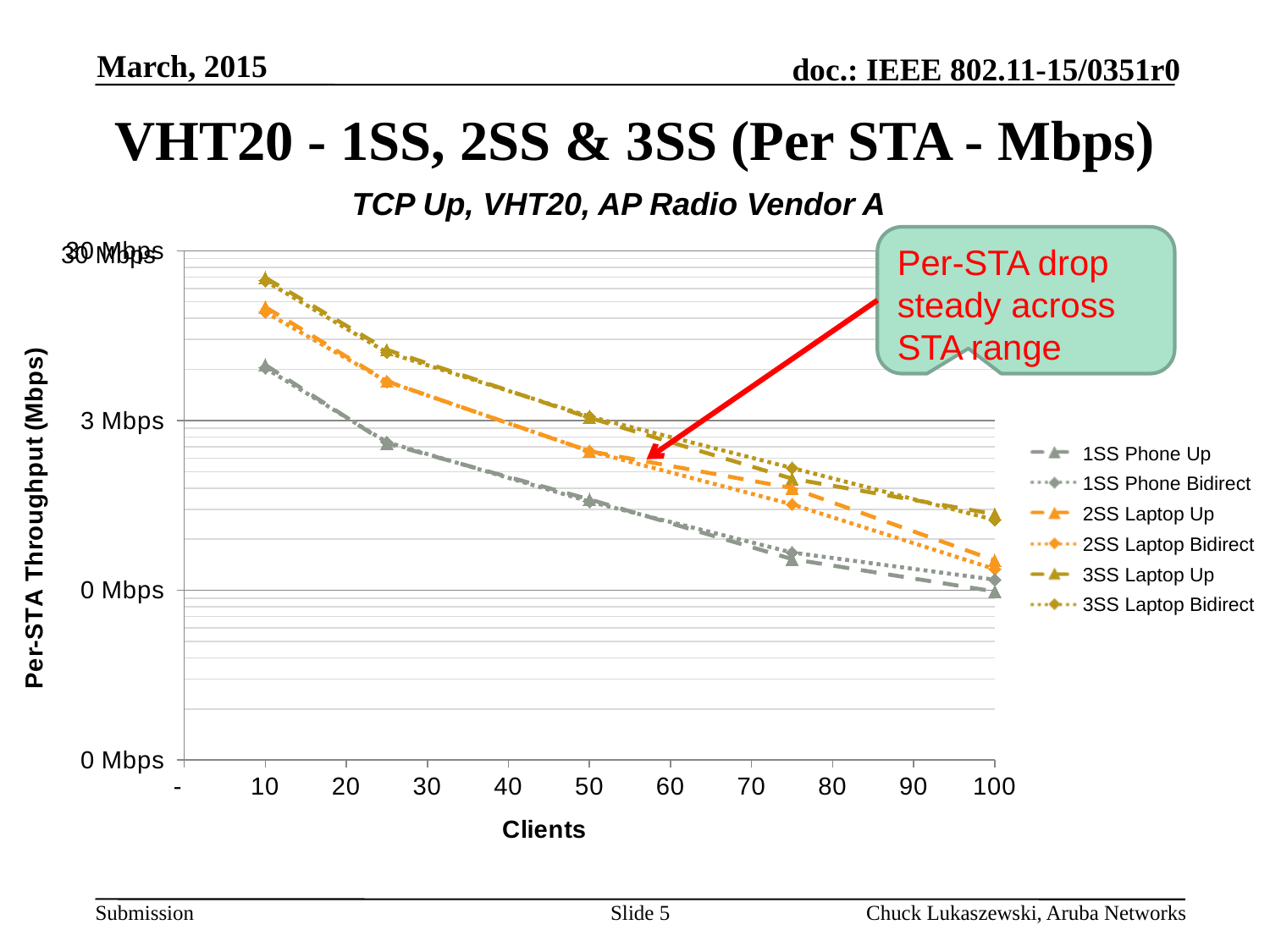
Is the value for 3SS Laptop Up at 10 clients greater or less than 3 Mbps? greater At 50 clients, which is larger: 2SS Laptop Up or 1SS Phone Up? 2SS Laptop Up Do the per-STA throughput values rise or fall as the number of clients increases? Fall What is the title of the chart? TCP Up, VHT20, AP Radio Vendor A How many data points are plotted for each series? 5 At 100 clients, which is larger: 3SS Laptop Up or 1SS Phone Up? 3SS Laptop Up Which series has the highest per-STA throughput at 10 clients? 3SS Laptop Up How many series does the chart legend list? 6 What is the label of the x axis? Clients Is the value for 1SS Phone Up at 100 clients greater or less than 3 Mbps? less What kind of chart is shown on the slide? Line chart